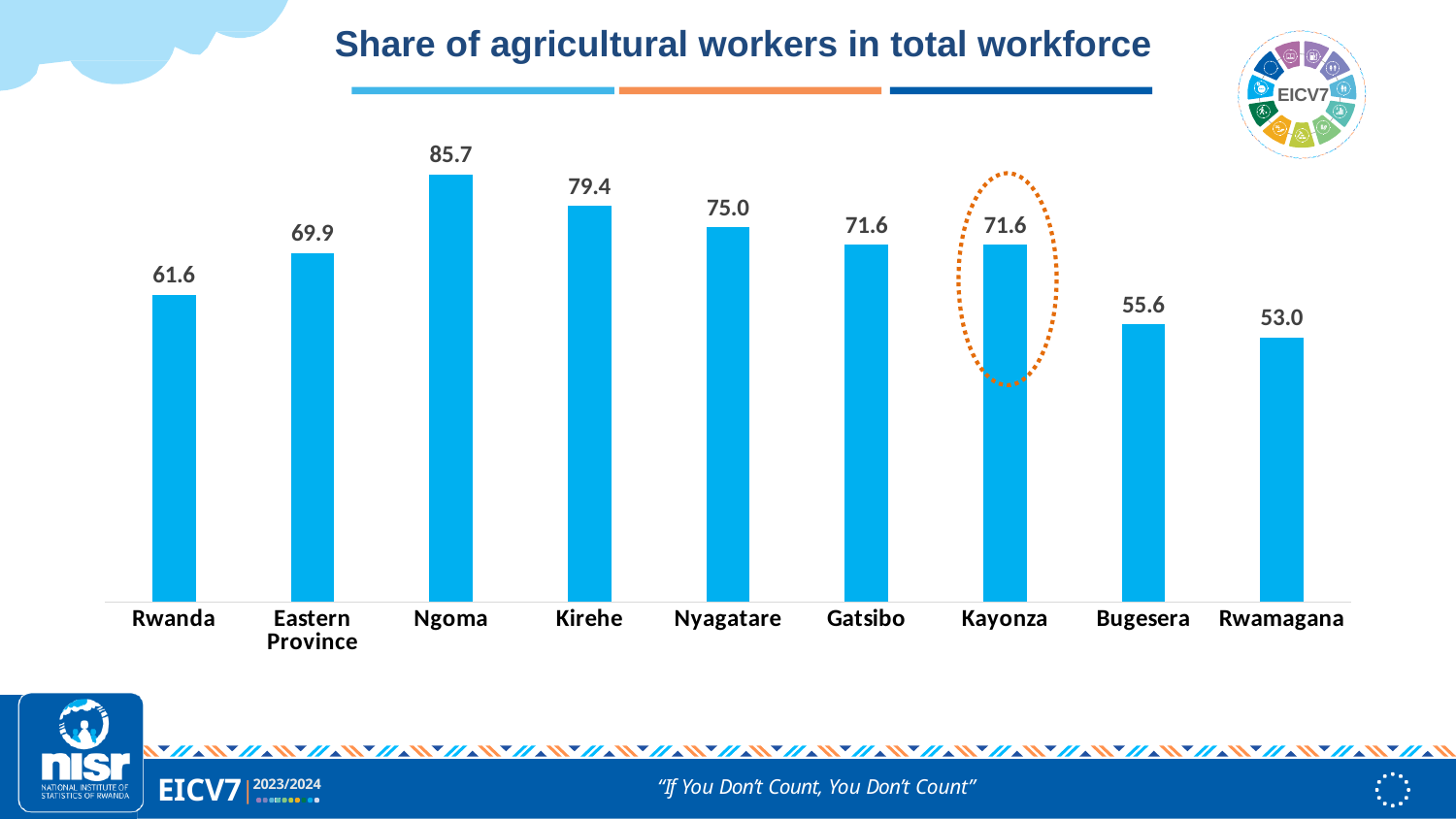
What is the title of the chart? Share of agricultural workers in total workforce Which has a larger value, Kirehe or Nyagatare? Kirehe Which category has the lowest share of agricultural workers? Rwamagana What kind of chart is shown on the slide? Bar chart What is the difference between the values for Ngoma and Rwamagana? 32.7 What is the difference between the values for Eastern Province and Rwanda? 8.3 How many categories are shown on the x axis? 9 Which category has the highest share of agricultural workers? Ngoma What is the value shown for Rwanda? 61.6 What is the share of agricultural workers in the total workforce for Ngoma? 85.7 What is the value shown for Bugesera? 55.6 Which category's bar is highlighted with a dotted orange oval? Kayonza